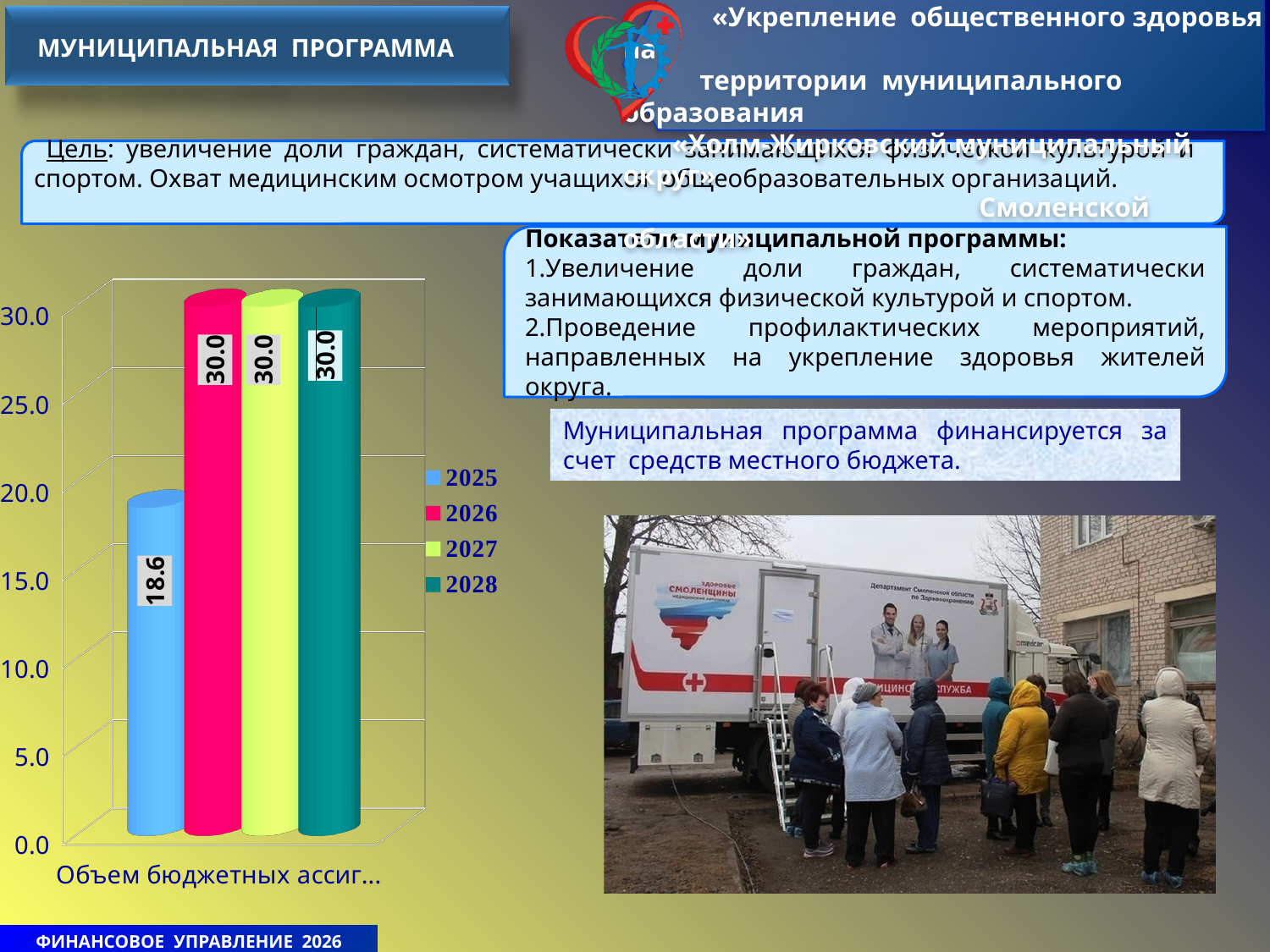
What kind of chart is shown on the slide? bar chart What is the difference between the values for 2026 and 2025? 11.4 Which is larger, the value for 2025 or the value for 2027? 2027 What is the highest value shown on the vertical axis of the chart? 30.0 Which year has the lowest value in the chart? 2025 Which colour represents 2026 in the legend? pink What is the value for 2026 in the chart? 30.0 Do the values rise or fall from 2025 to 2026? rise Is the value for 2025 greater or less than 20.0? less How many series does the legend list? 4 What is the value for 2028 in the chart? 30.0 What is the value for 2025 in the chart? 18.6